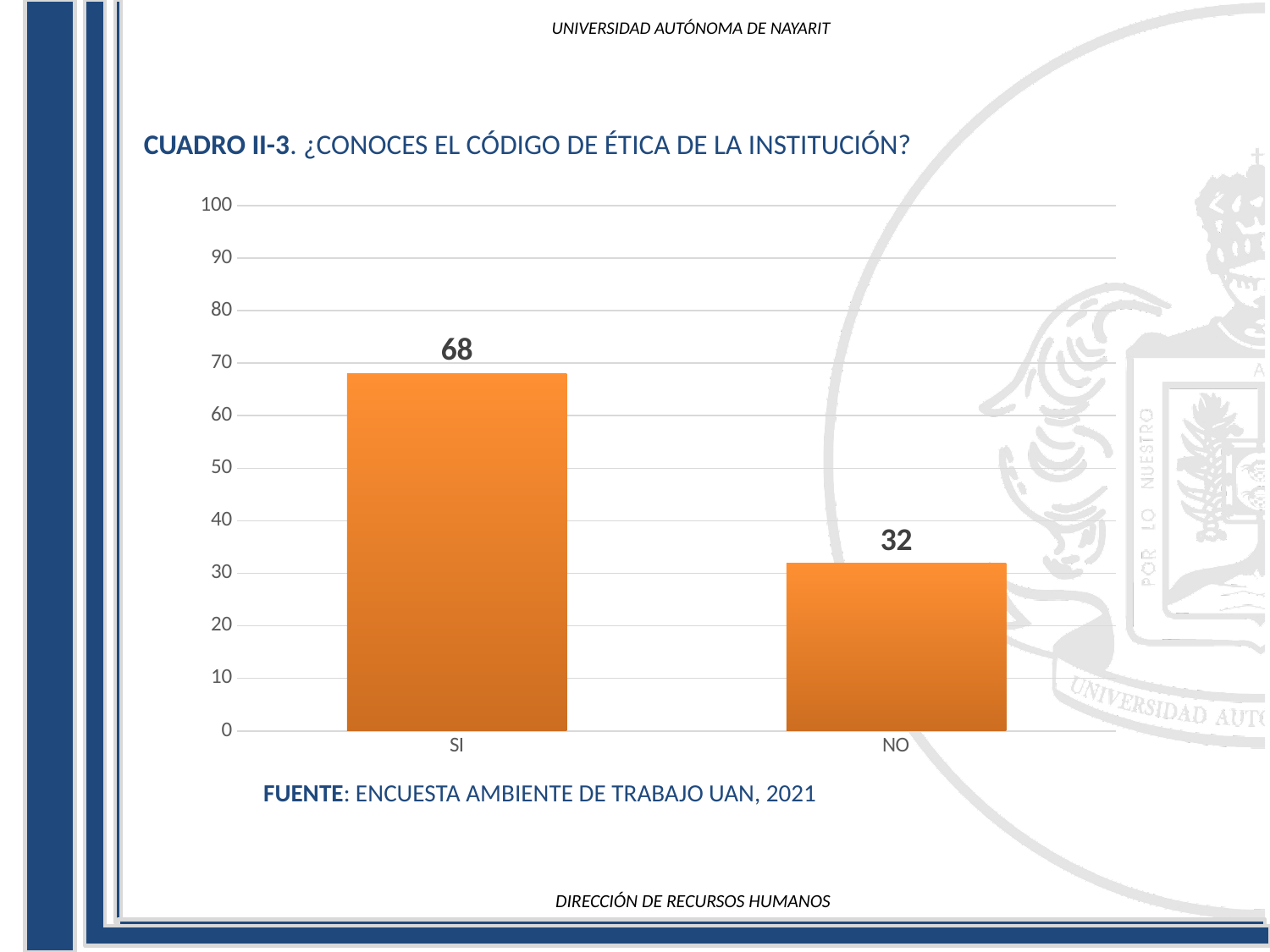
What is the value for SI? 68 What is the value for NO? 32 What kind of chart is shown on the slide? bar chart What is the difference between the values for SI and NO? 36 How many categories are shown on the x axis? 2 Which category has the highest value? SI Which category has the lowest value? NO Is the value for NO greater or less than 40? less Is the value for SI greater or less than 60? greater What is the total of the two bar values? 100 Which is larger, the value for SI or the value for NO? SI What is the source cited below the chart? ENCUESTA AMBIENTE DE TRABAJO UAN, 2021